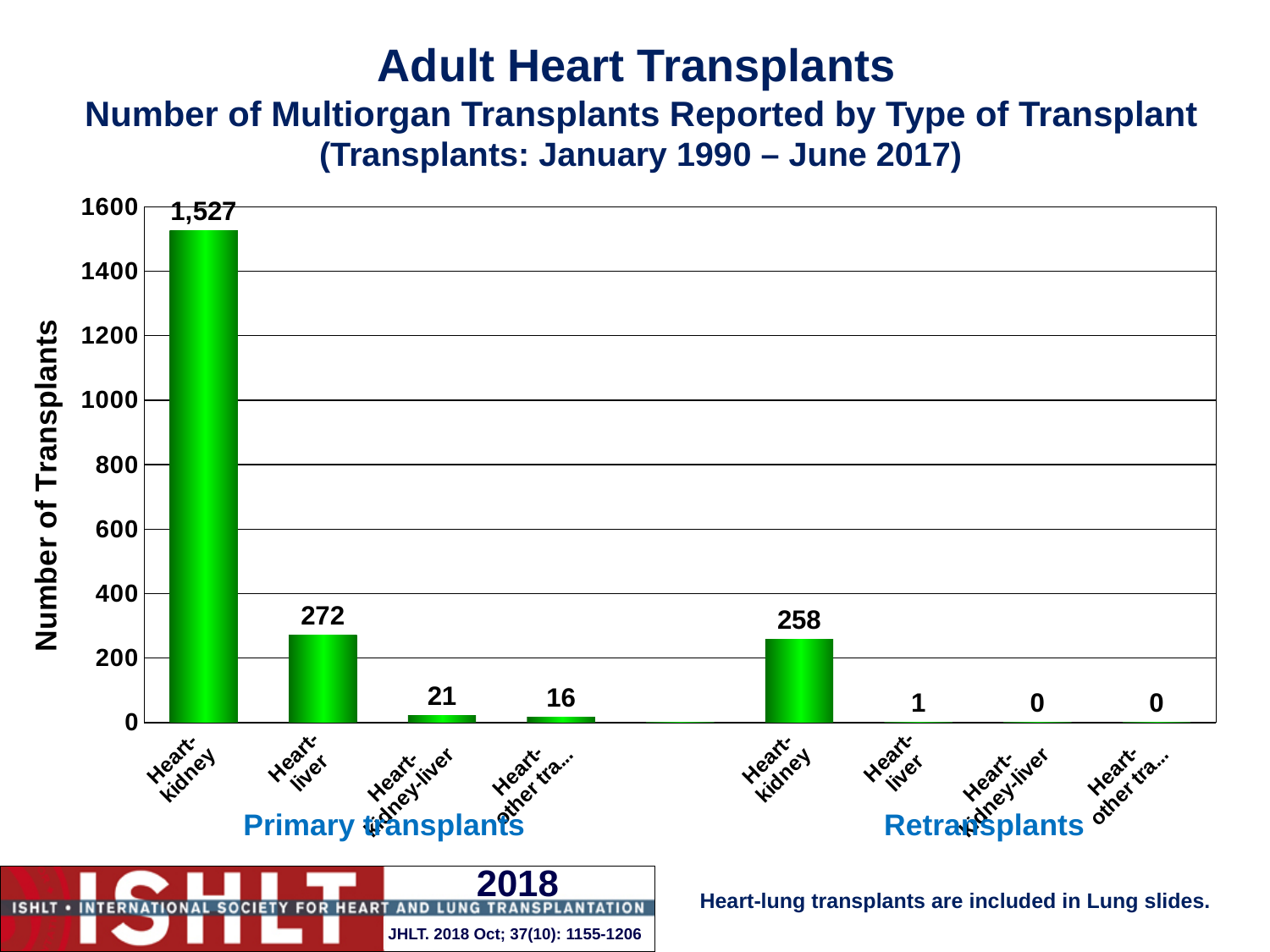
How many bars/categories are plotted on the chart in total? 8 Which category has the highest number of transplants on the chart? Heart-kidney (Primary transplants) What type of chart is shown on the slide? Bar chart What is the number of heart-kidney-liver primary transplants? 21 What is the number of heart-kidney retransplants? 258 What is the total number of heart-kidney-liver and heart-other primary transplants combined? 37 What is the number of heart-liver retransplants? 1 What is the label of the y-axis? Number of Transplants Which is larger: heart-liver primary transplants or heart-kidney retransplants? Heart-liver primary transplants What is the difference between heart-kidney primary transplants and heart-kidney retransplants? 1,269 How many heart-kidney primary transplants are shown on the chart? 1,527 What is the number of heart-liver primary transplants? 272